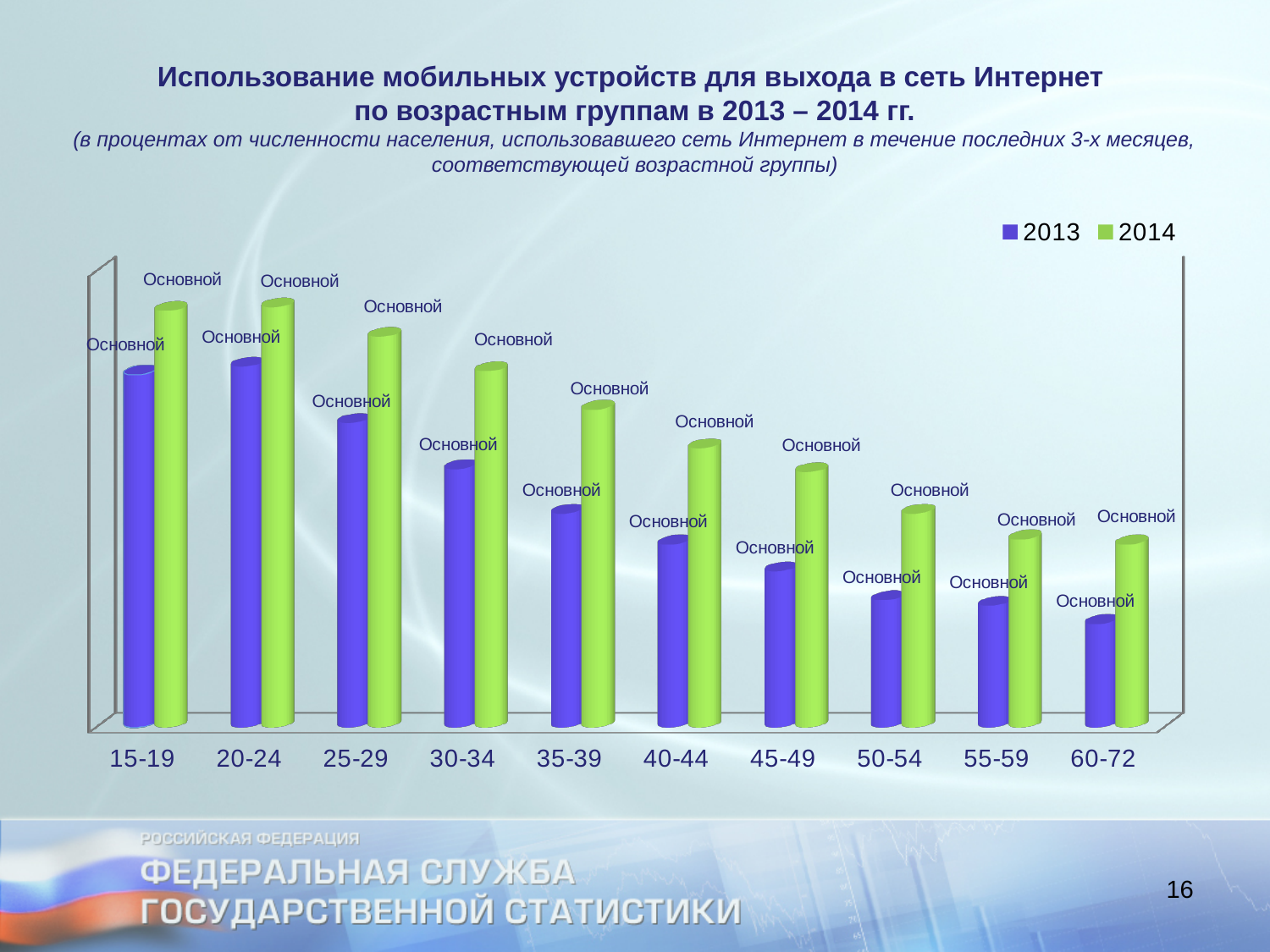
Which is larger for 2013: the value for 15-19 or the value for 45-49? 15-19 What are the two series named in the chart's legend? 2013 and 2014 Which age group has the lowest value for 2013? 60-72 What kind of chart is shown on the slide? bar chart Do the values for 2014 rise or fall as the age groups increase along the x axis? fall How many series does the chart's legend list? 2 For the 60-72 age group, which is larger: the 2013 value or the 2014 value? 2014 Do the values for 2013 rise or fall as the age groups increase along the x axis? fall Which series is shown in green in the chart? 2014 Which is larger for 2014: the value for 25-29 or the value for 35-39? 25-29 How many age groups are shown on the x axis of the chart? 10